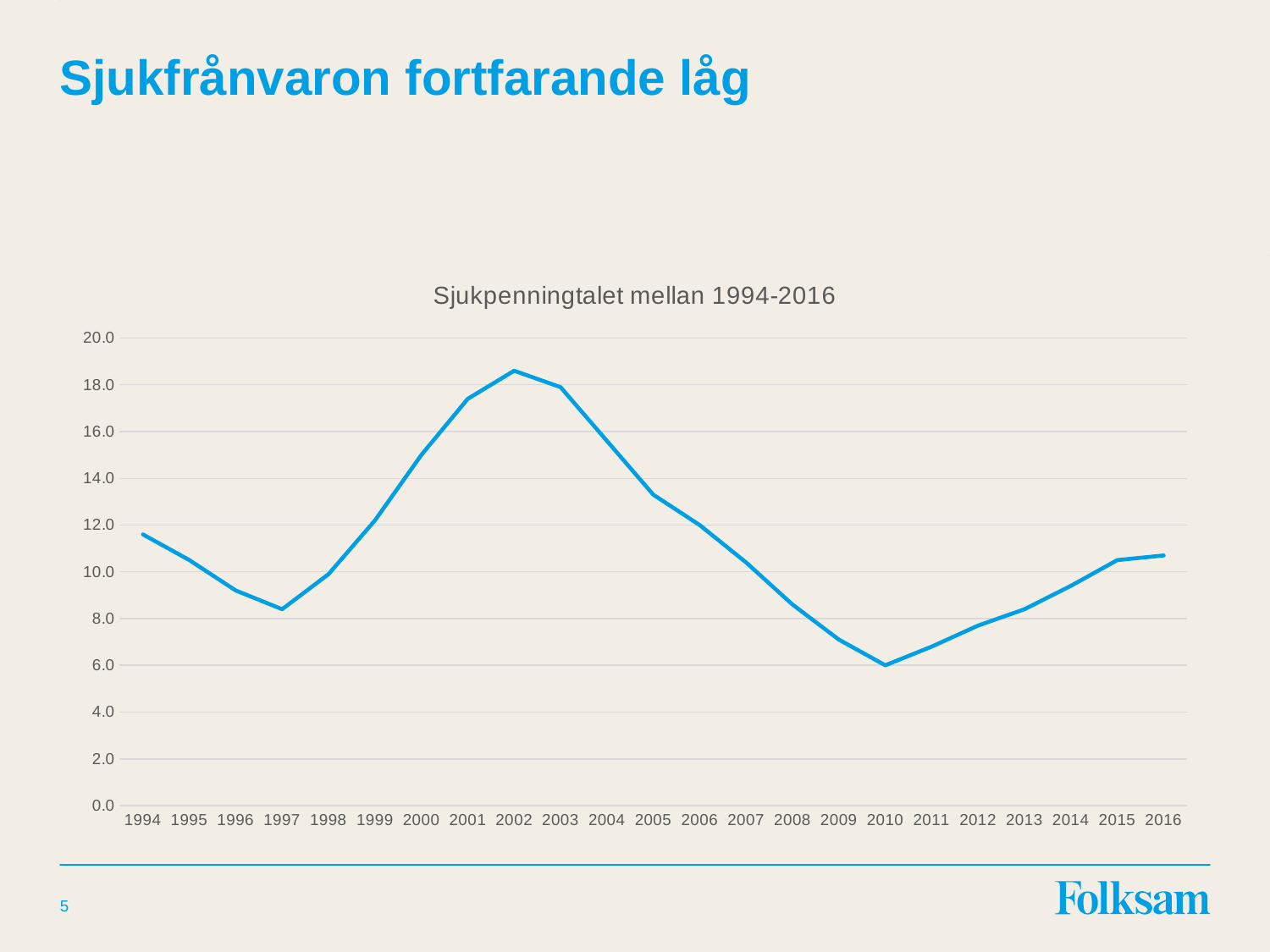
Do the values rise or fall between 2002 and 2010? fall Is the value for 2002 greater or less than 18.0? greater In which year does the line reach its lowest value? 2010 Is the value for 2016 greater or less than 10.0? greater Which year has the larger value, 1994 or 2016? 1994 How many years are plotted along the x axis? 23 Which year has the larger value, 2005 or 2008? 2005 What is the title of the chart? Sjukpenningtalet mellan 1994-2016 In which year does the line reach its highest value? 2002 What kind of chart is shown on the slide? line chart Is the value for 1997 greater or less than 10.0? less